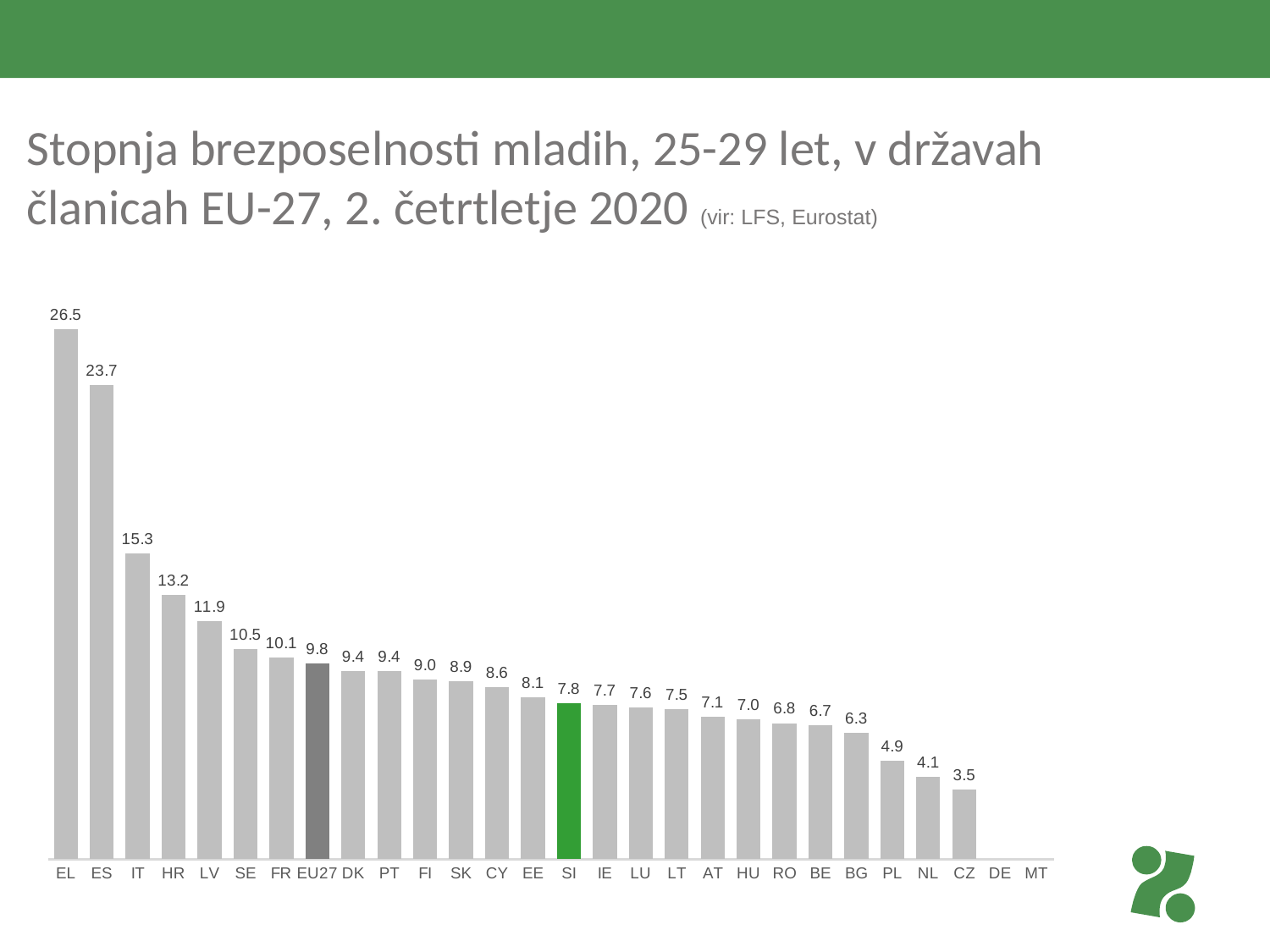
Which category with a plotted bar has the lowest value? CZ Do the values rise or fall from left to right along the x axis? fall Which category has the highest value? EL What is the value for SI? 7.8 What is the difference between the values for EL and ES? 2.8 What is the value for CZ? 3.5 What is the value for EL? 26.5 What is the value for EU27? 9.8 What colour is the bar for SI? green Which is larger, the value for IT or the value for HR? IT What type of chart is shown on the slide? bar chart What is the difference between the values for EU27 and SI? 2.0